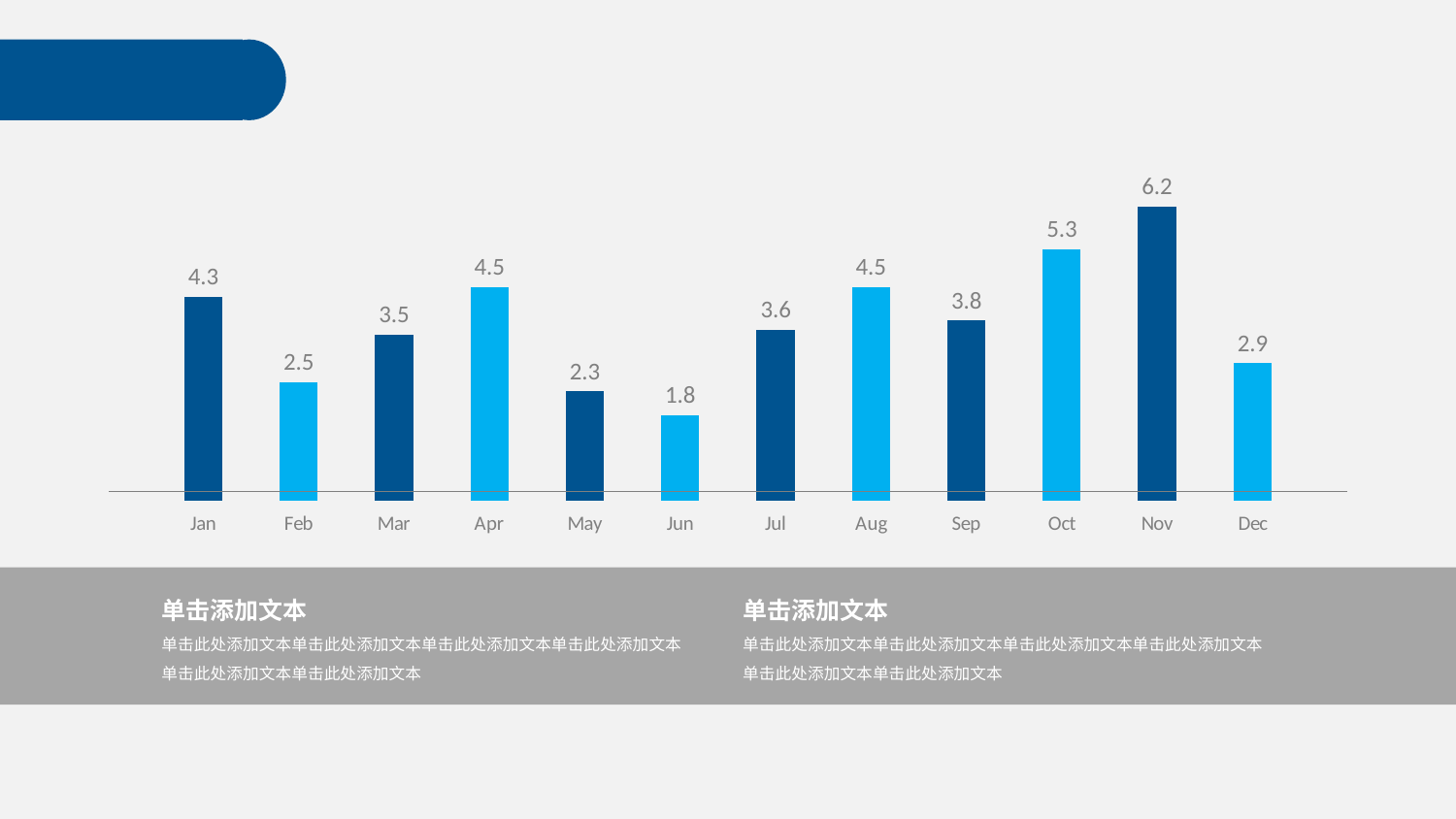
How many months are shown on the x axis? 12 Which month has the lowest value? Jun Which months have a value of 4.5? Apr and Aug What is the value for Oct? 5.3 Which is larger, the value for Mar or the value for Sep? Sep What is the value for Jan? 4.3 What is the difference between the values for Jan and Feb? 1.8 Do the values rise or fall from Aug to Nov? Rise What is the value for Jun? 1.8 Which month has the highest value? Nov What is the difference between the values for Nov and Dec? 3.3 What kind of chart is shown on the slide? Bar chart